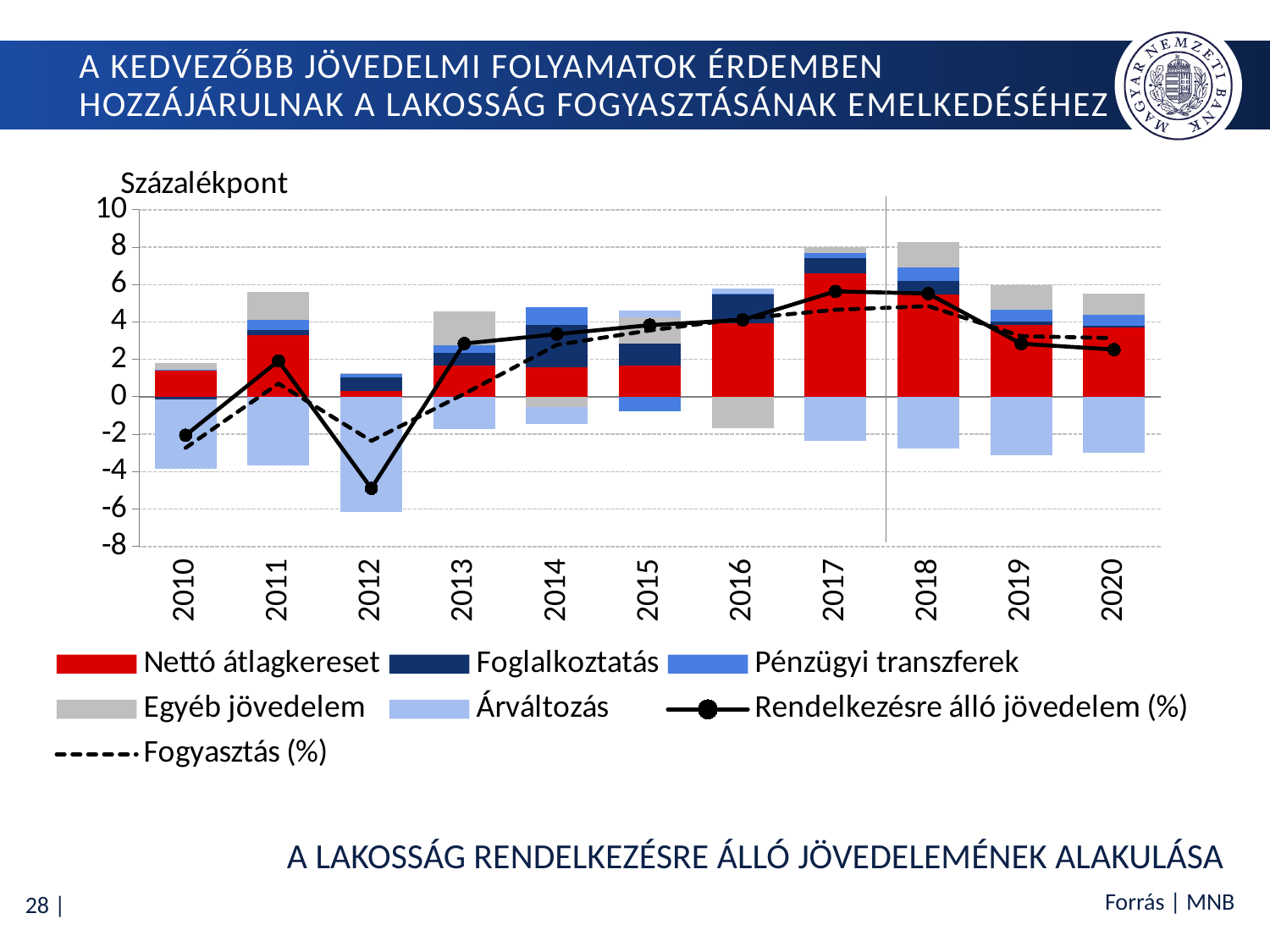
In which year is the Rendelkezésre álló jövedelem (%) line at its lowest? 2012 Which year has the larger Rendelkezésre álló jövedelem (%) value, 2011 or 2012? 2011 What kind of chart is shown on the slide? A stacked bar chart combined with line series Is the Fogyasztás (%) value in 2010 greater or less than 0? less Is the value of Rendelkezésre álló jövedelem (%) in 2012 greater or less than -4? less What is the title shown below the chart? A lakosság rendelkezésre álló jövedelemének alakulása Does the Rendelkezésre álló jövedelem (%) line rise or fall between 2012 and 2017? rise How many years are shown on the x axis of the chart? 11 Is the value of Rendelkezésre álló jövedelem (%) in 2017 greater or less than 4? greater How many series does the chart's legend list? 7 What is the unit label shown above the y axis of the chart? Százalékpont